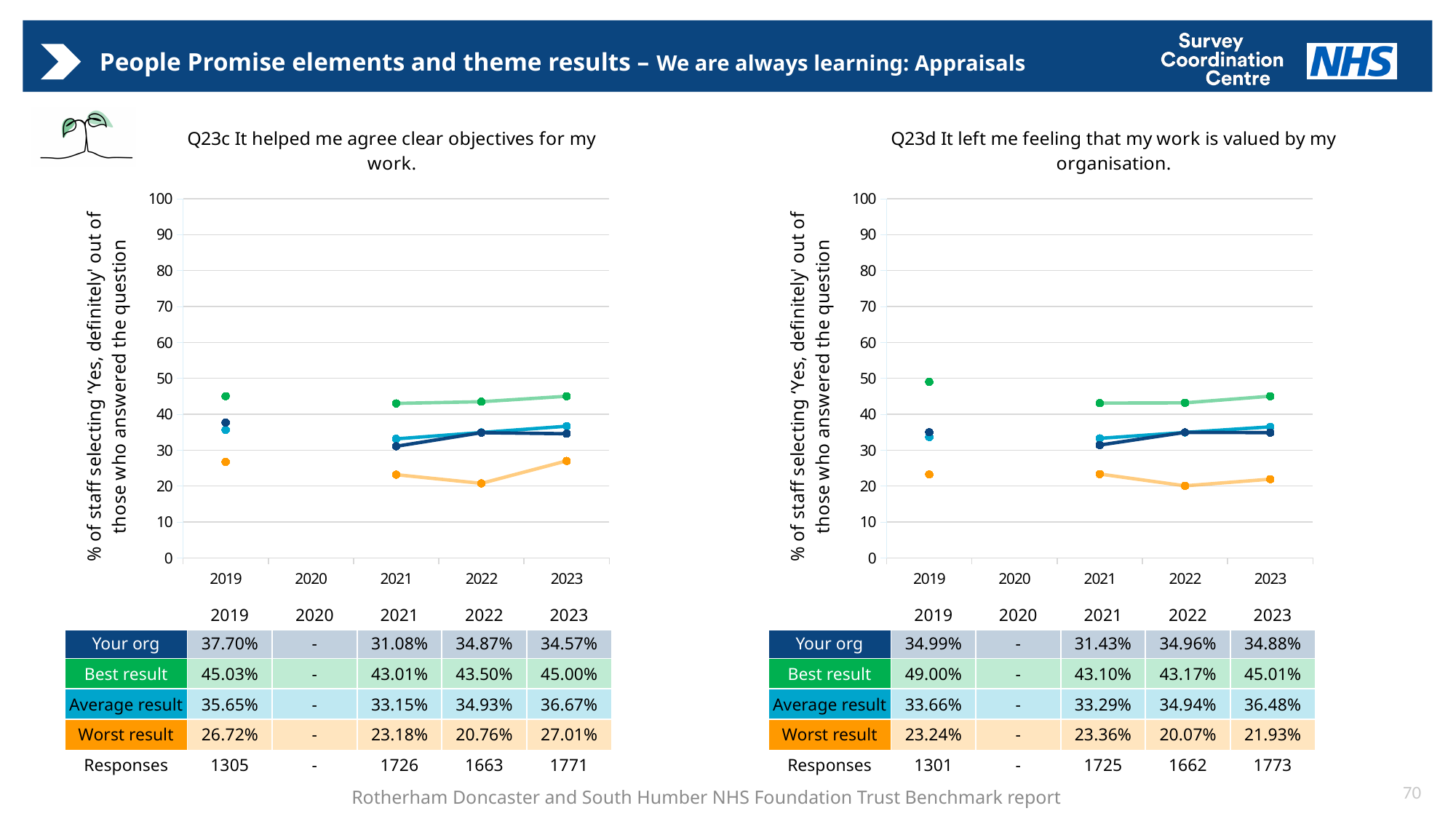
In the Q23c chart, what was the Your org value in 2022? 34.87% In the Q23d chart, in which year was the Worst result lowest? 2022 How many series does each chart's table list? 4 In the Q23c chart, what is the difference between the Best result and Your org in 2023? 10.43 percentage points In the Q23d chart, is the Worst result for 2022 greater or less than 30? less What kind of chart is used for Q23c? Line chart In the Q23c chart, in which year was the Worst result lowest? 2022 In the Q23d chart, by how much did Your org change from 2021 to 2023? 3.45 percentage points In the Q23c chart, does the Average result rise or fall from 2021 to 2023? Rise In the Q23d chart, what was the Best result in 2019? 49.00% In the Q23d chart, which was larger in 2019: Your org or the Average result? Your org In the Q23c chart, which was larger in 2023: Your org or the Average result? Average result